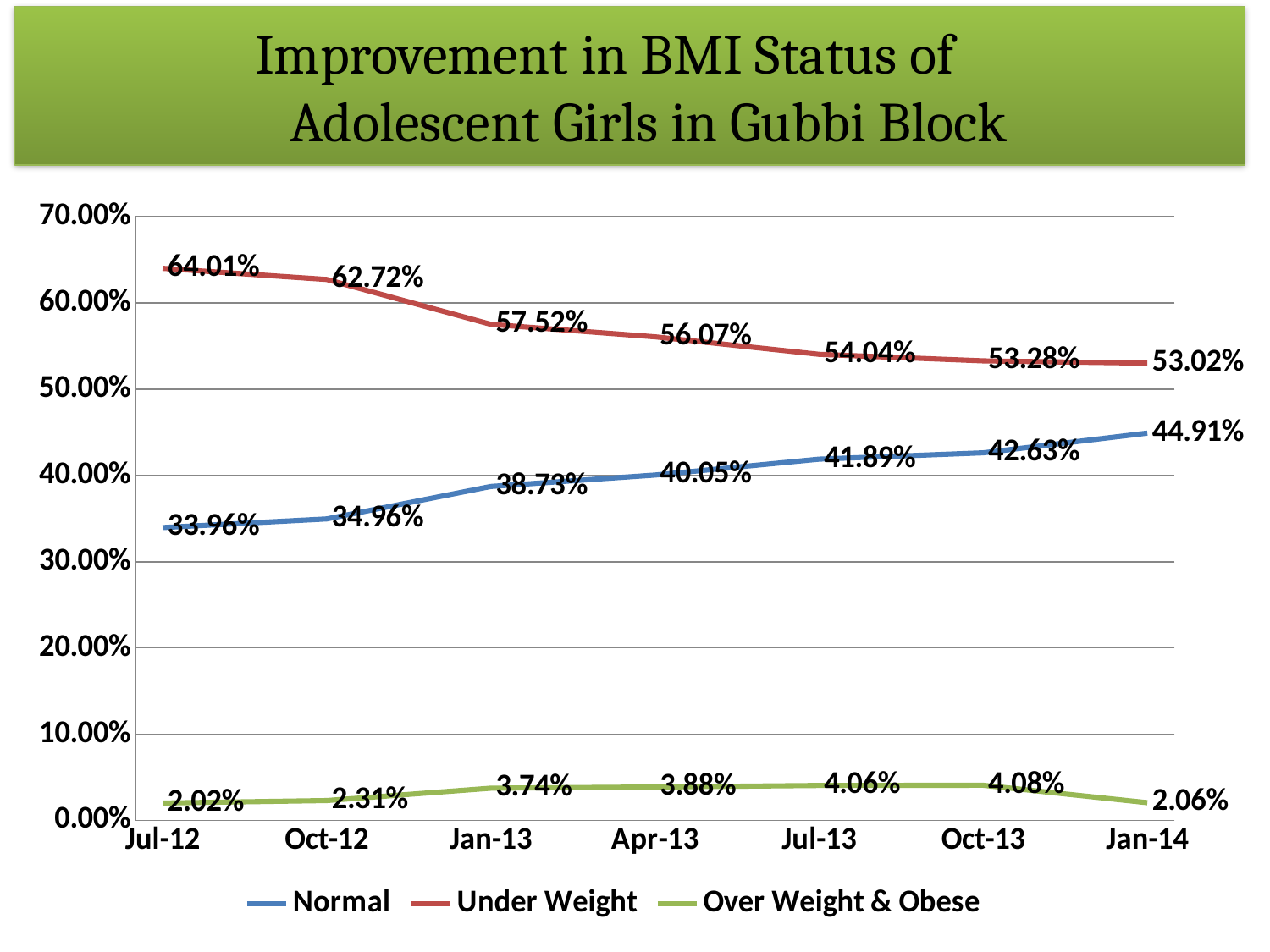
Which is larger at Jan-13: the Normal value or the Under Weight value? Under Weight How many dates are plotted on the x axis? 7 What is the difference between the Under Weight values for Jul-12 and Jan-14? 10.99% At which date is the Under Weight series lowest? Jan-14 At which date is the Normal series highest? Jan-14 What is the Normal value for Jan-14? 44.91% What is the Over Weight & Obese value for Oct-13? 4.08% What is the Under Weight value for Jul-12? 64.01% How many series does the legend list? 3 What is the title of the chart? Improvement in BMI Status of Adolescent Girls in Gubbi Block Does the Normal series rise or fall from Jul-12 to Jan-14? Rise What kind of chart is shown on the slide? Line chart